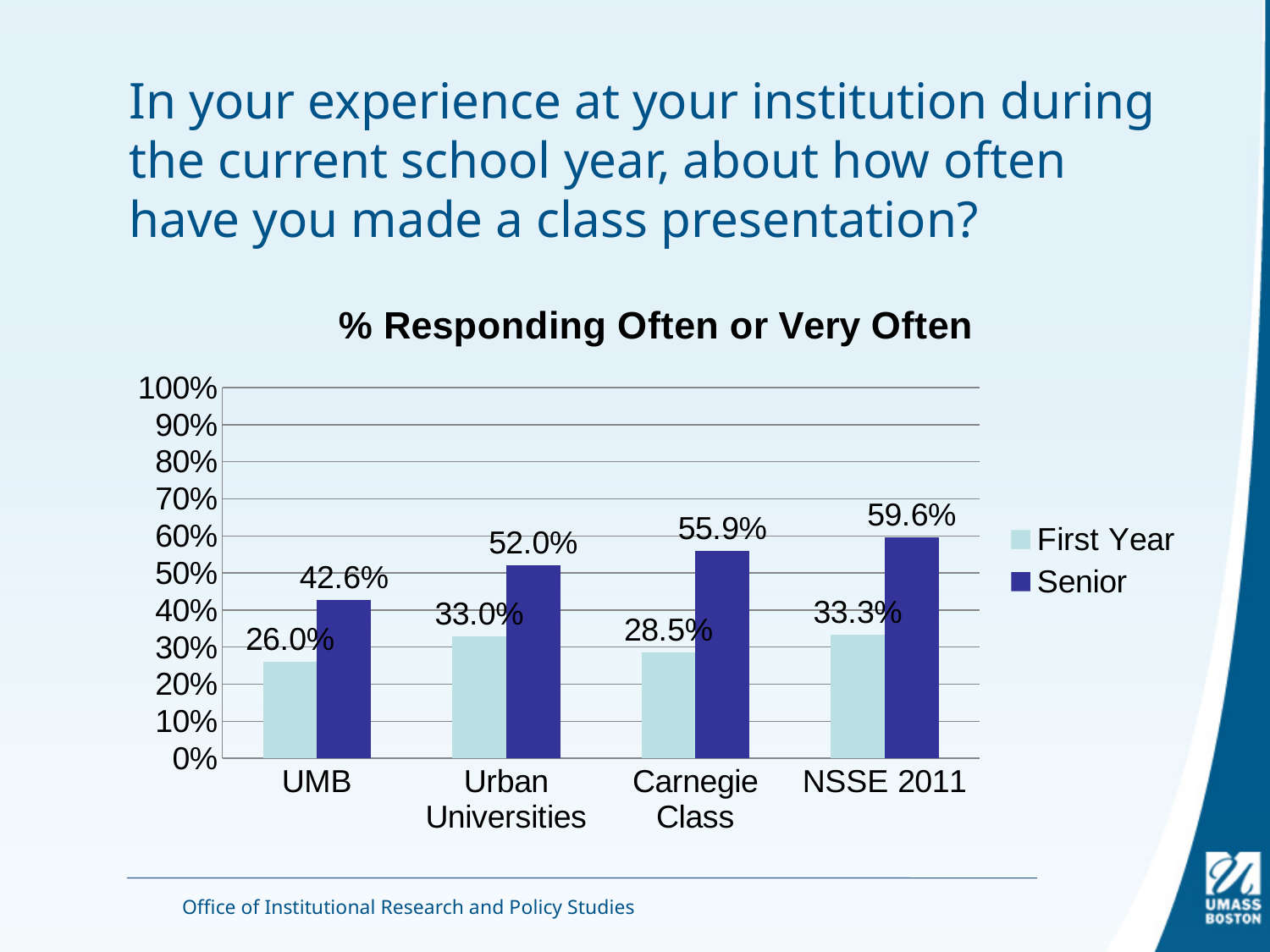
What is the Senior value for NSSE 2011? 59.6% What is the Senior value for Urban Universities? 52.0% How many categories are shown on the x axis? 4 How many series does the legend list? 2 Which is larger, the First Year value for Urban Universities or the First Year value for NSSE 2011? NSSE 2011 What is the First Year value for UMB? 26.0% What is the First Year value for Carnegie Class? 28.5% Which category has the highest Senior value? NSSE 2011 What is the difference between the Senior and First Year values for UMB? 16.6% Which category has the lowest First Year value? UMB What is the title of the chart? % Responding Often or Very Often What kind of chart is shown? Bar chart